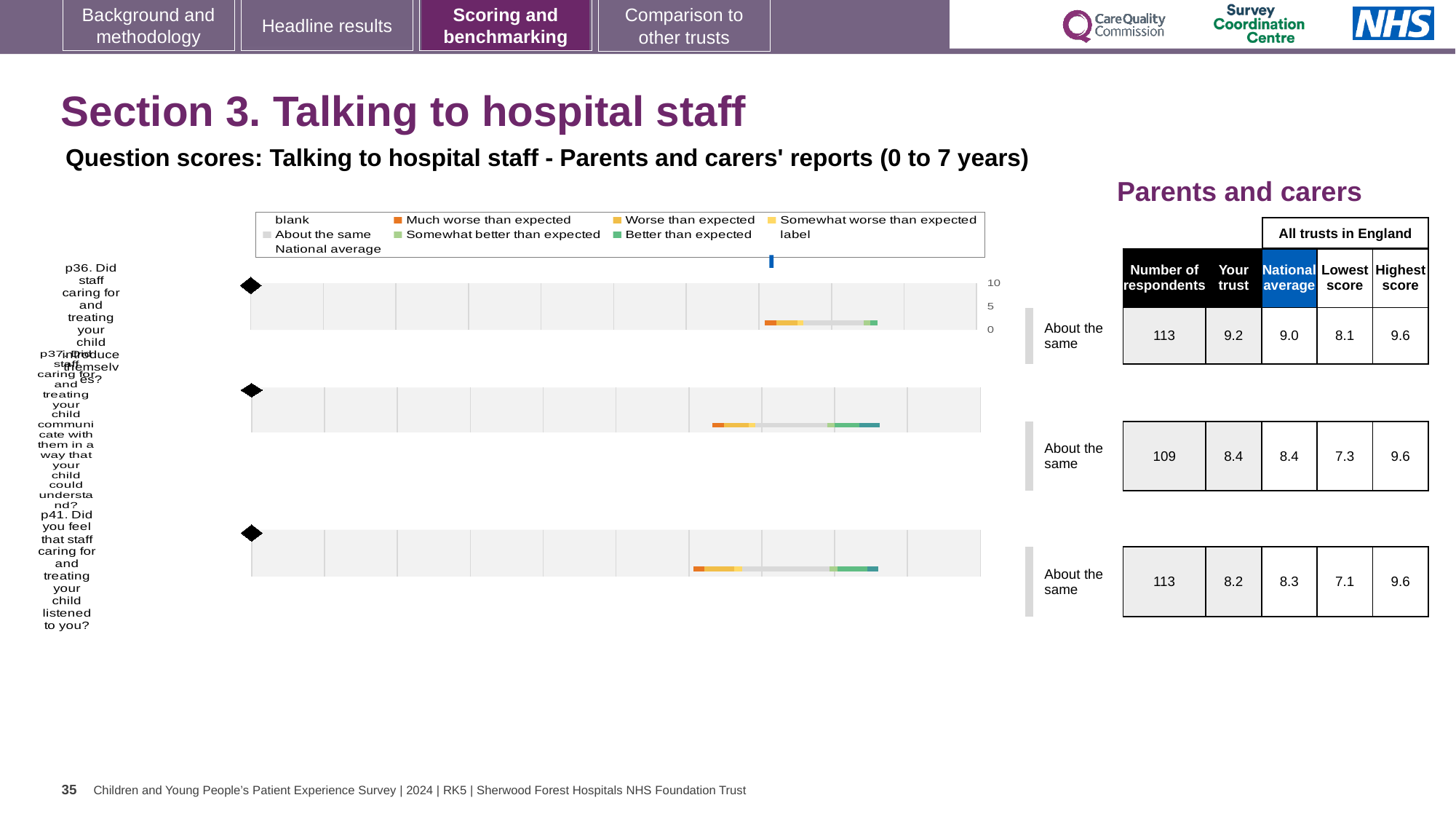
How many respondents answered p41 (Did you feel that staff listened to you)? 113 For p41, which is larger: the trust score or the national average? national average Which question has the highest 'Your trust' score? p36 How many survey questions (p36, p37, p41) are plotted on the slide? 3 Which question has the lowest 'Your trust' score? p41 What colour does the legend use for 'Much worse than expected'? orange What kind of chart is used to show the question scores on this slide? bar chart What is the highest score among all trusts in England for p36? 9.6 What is the national average score for p37 (Did staff communicate with your child in a way they could understand)? 8.4 What is the 'Your trust' score for p36 (Did staff caring for and treating your child introduce themselves)? 9.2 What is the difference between the trust score and the national average for p36? 0.2 What benchmark category is shown for all three questions on this slide? About the same